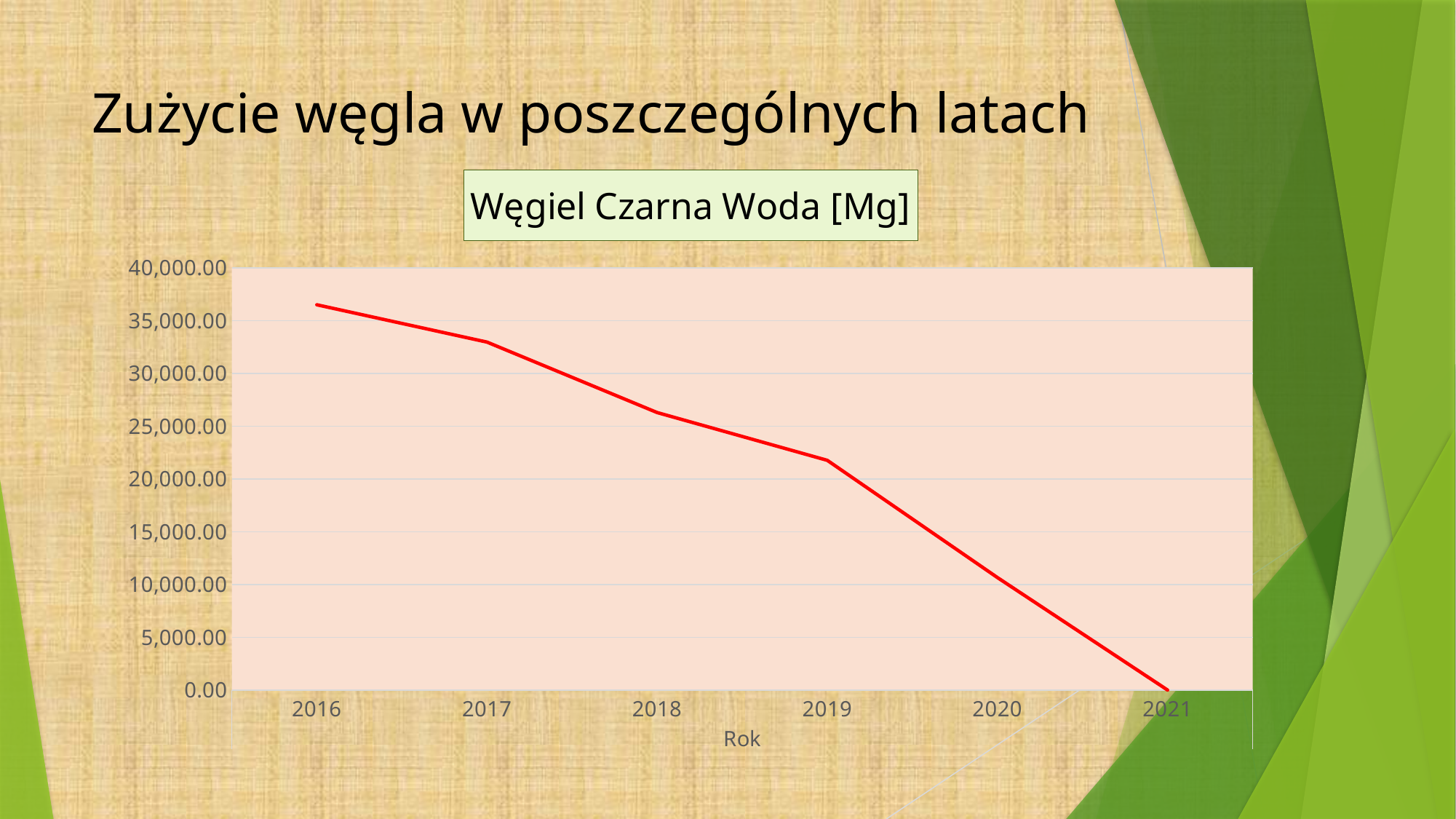
What is the title of the chart? Węgiel Czarna Woda [Mg] Which year has the lowest value? 2021 What kind of chart is shown on the slide? line chart Is the value for 2018 greater or less than 25,000.00? greater Which year has the highest value? 2016 What is the label of the x axis? Rok How many years are plotted on the x axis? 6 Is the value for 2016 greater or less than 35,000.00? greater Do the values rise or fall from 2016 to 2021? fall Is the value for 2021 greater or less than 5,000.00? less Which year has the larger value, 2017 or 2019? 2017